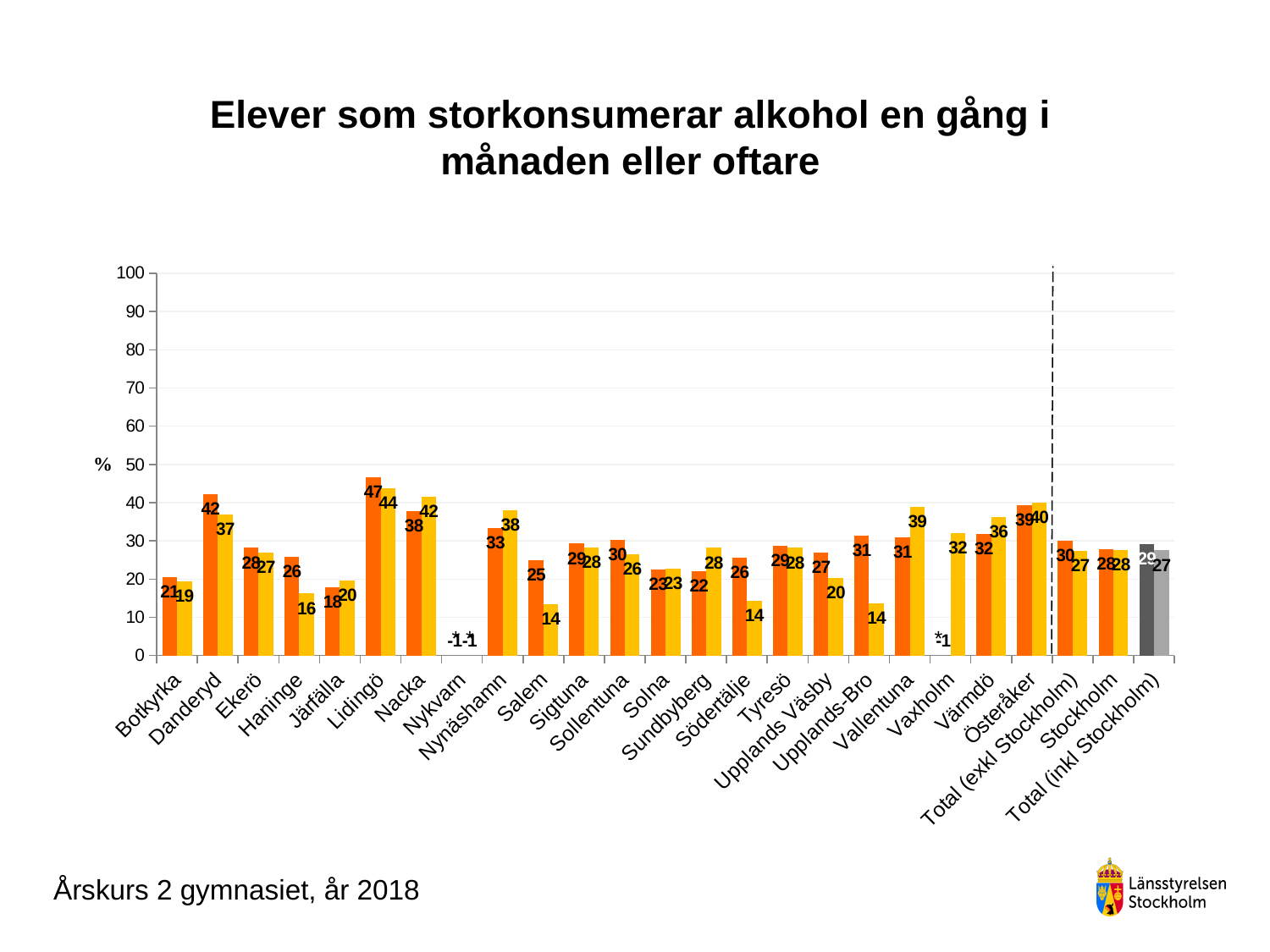
Which is larger, the orange bar for Lidingö or the orange bar for Nacka? Lidingö What kind of chart is shown on the slide? bar chart Which category has the highest orange bar? Lidingö What is the value of the orange bar for Lidingö? 47 How many categories are shown along the x axis of the chart? 25 Is the value of the orange bar for Lidingö greater or less than 40? greater What is the title of the chart? Elever som storkonsumerar alkohol en gång i månaden eller oftare What is the value of the yellow bar for Vallentuna? 39 What is the value of the yellow bar for Danderyd? 37 Which category has the highest yellow bar? Lidingö What is the difference between the orange and yellow bars for Danderyd? 5